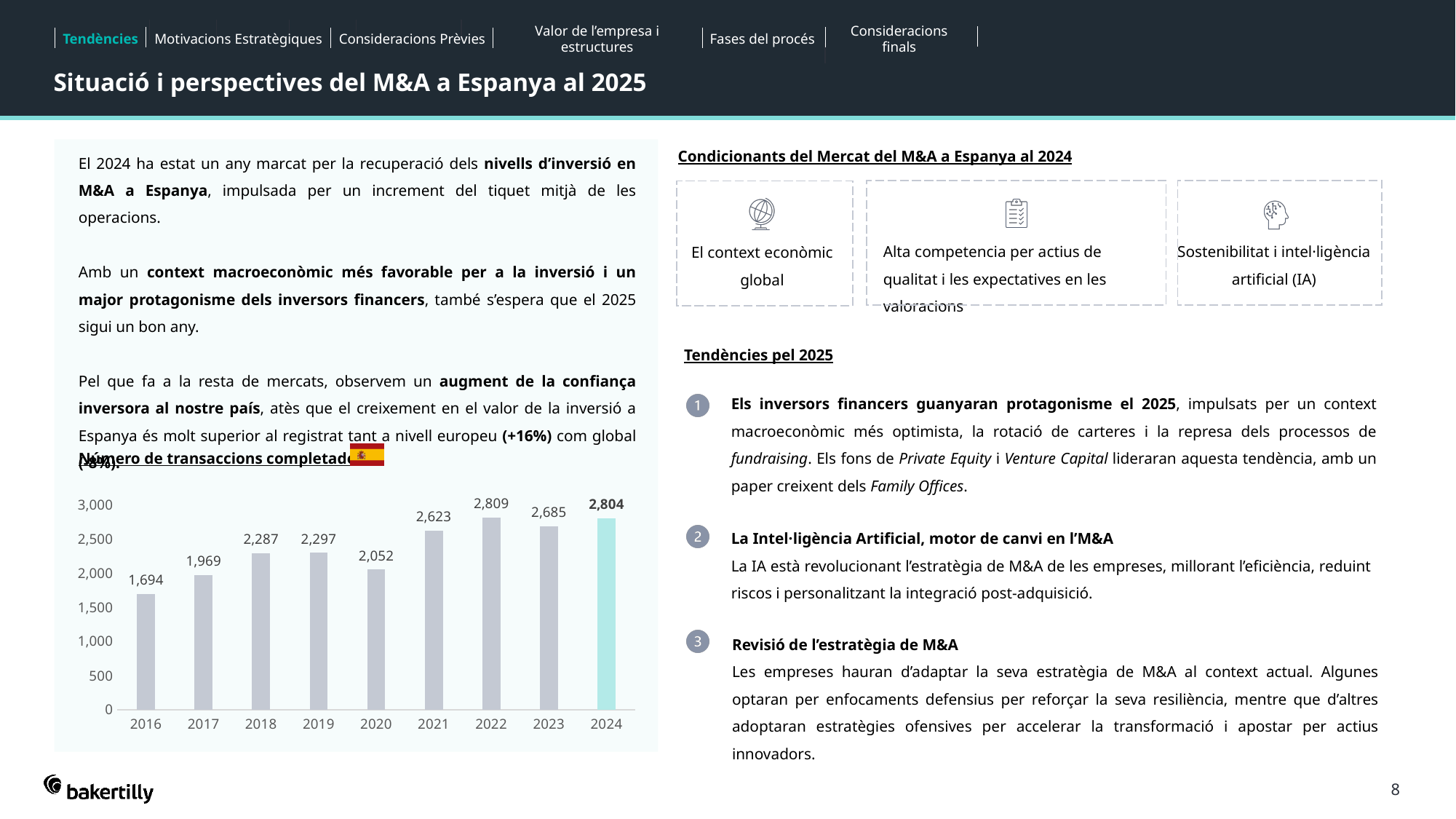
Which year has the lowest number of completed transactions? 2016 What value does the chart show for 2024? 2,804 Is the value for 2017 greater or less than 2,000? less How many years are shown on the x axis of the chart? 9 What kind of chart is used to show the number of completed transactions? bar chart What is the difference between the values for 2024 and 2016? 1,110 Which year has a higher value, 2019 or 2020? 2019 What is the difference between the values for 2022 and 2023? 124 What is the value plotted for 2020? 2,052 Which year has a higher value, 2021 or 2023? 2023 What is the number of completed transactions shown for 2016? 1,694 Which bar in the chart is highlighted in a different colour from the others? 2024